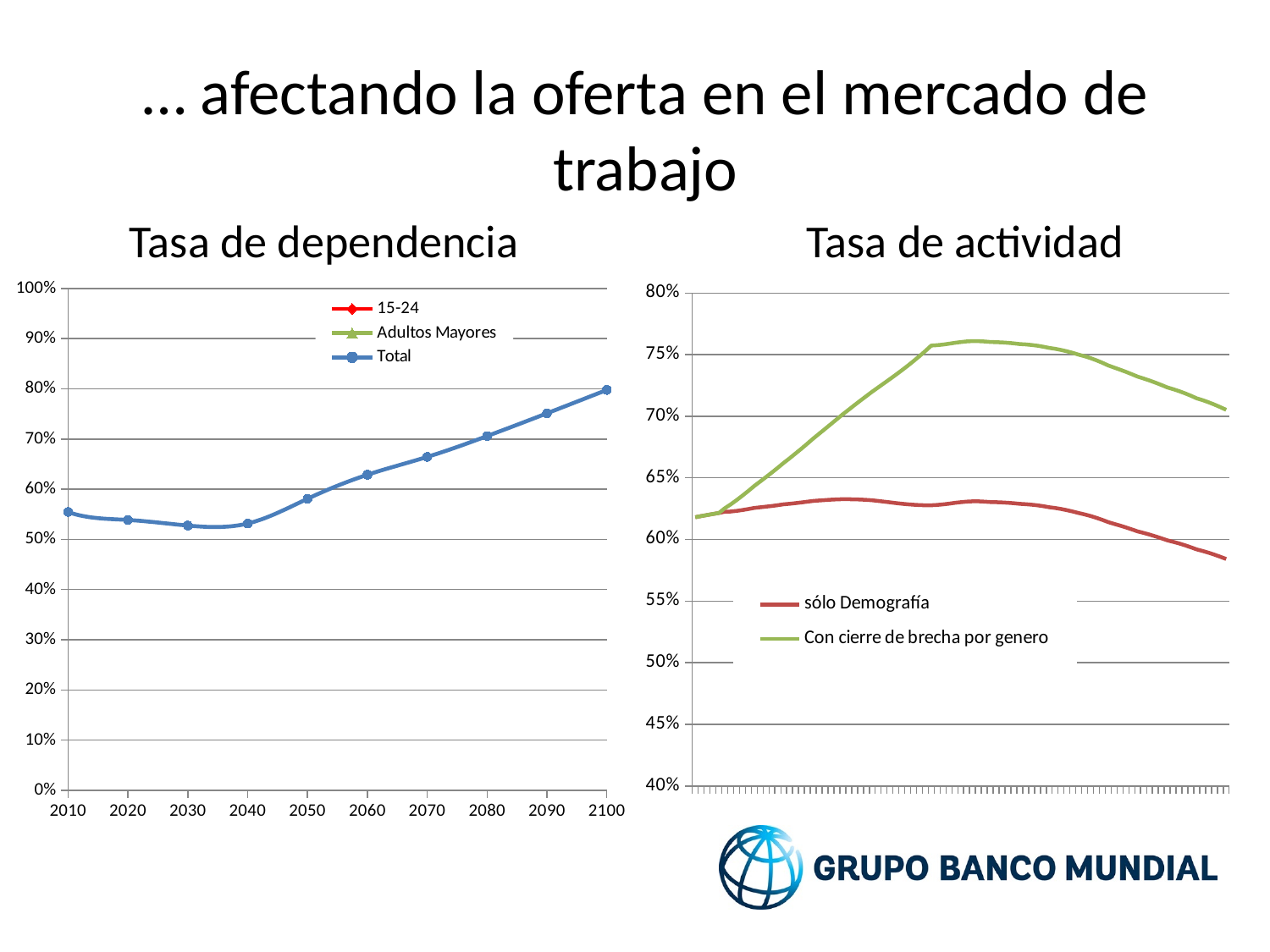
How many years are labelled on the x axis of the 'Tasa de dependencia' chart? 10 In the 'Tasa de dependencia' chart, which year has the highest Total value? 2100 In the 'Tasa de dependencia' chart, is the Total value for 2100 greater or less than 70%? greater What type of chart is the 'Tasa de actividad' chart? line chart In the 'Tasa de actividad' chart, at the right end of the x axis, which series is higher: 'sólo Demografía' or 'Con cierre de brecha por genero'? Con cierre de brecha por genero How many series does the legend of the 'Tasa de dependencia' chart list? 3 In the 'Tasa de actividad' chart, is the peak of the 'Con cierre de brecha por genero' series greater or less than 75%? greater What type of chart is the 'Tasa de dependencia' chart? line chart In the 'Tasa de dependencia' chart, is the Total value for 2030 greater or less than 60%? less How many series does the legend of the 'Tasa de actividad' chart list? 2 What colour is the 'sólo Demografía' line in the 'Tasa de actividad' chart? red In the 'Tasa de dependencia' chart, does the Total series rise or fall between 2040 and 2100? rise